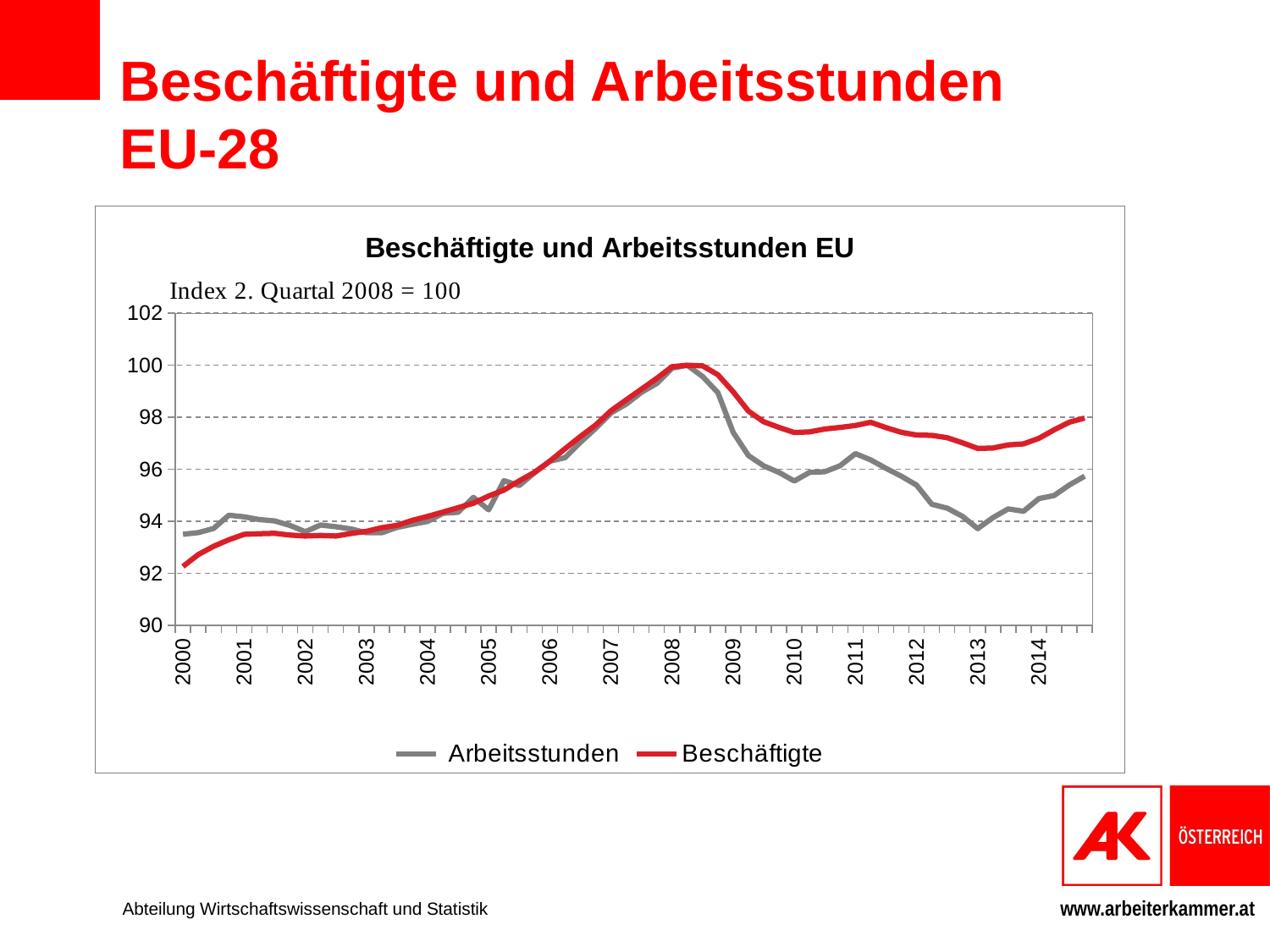
How many series does the legend list? 2 Is the value for Beschäftigte in 2000 greater or less than 94? less In 2000, which series has the higher value, Arbeitsstunden or Beschäftigte? Arbeitsstunden Does the Arbeitsstunden series rise or fall between 2008 and 2009? fall Is the value for Beschäftigte in 2013 greater or less than 96? greater Which two series are listed in the chart legend? Arbeitsstunden and Beschäftigte In which year does the Beschäftigte series reach its highest value? 2008 In 2013, which series has the higher value, Arbeitsstunden or Beschäftigte? Beschäftigte What is the title of the chart? Beschäftigte und Arbeitsstunden EU What kind of chart is shown on the slide? line chart